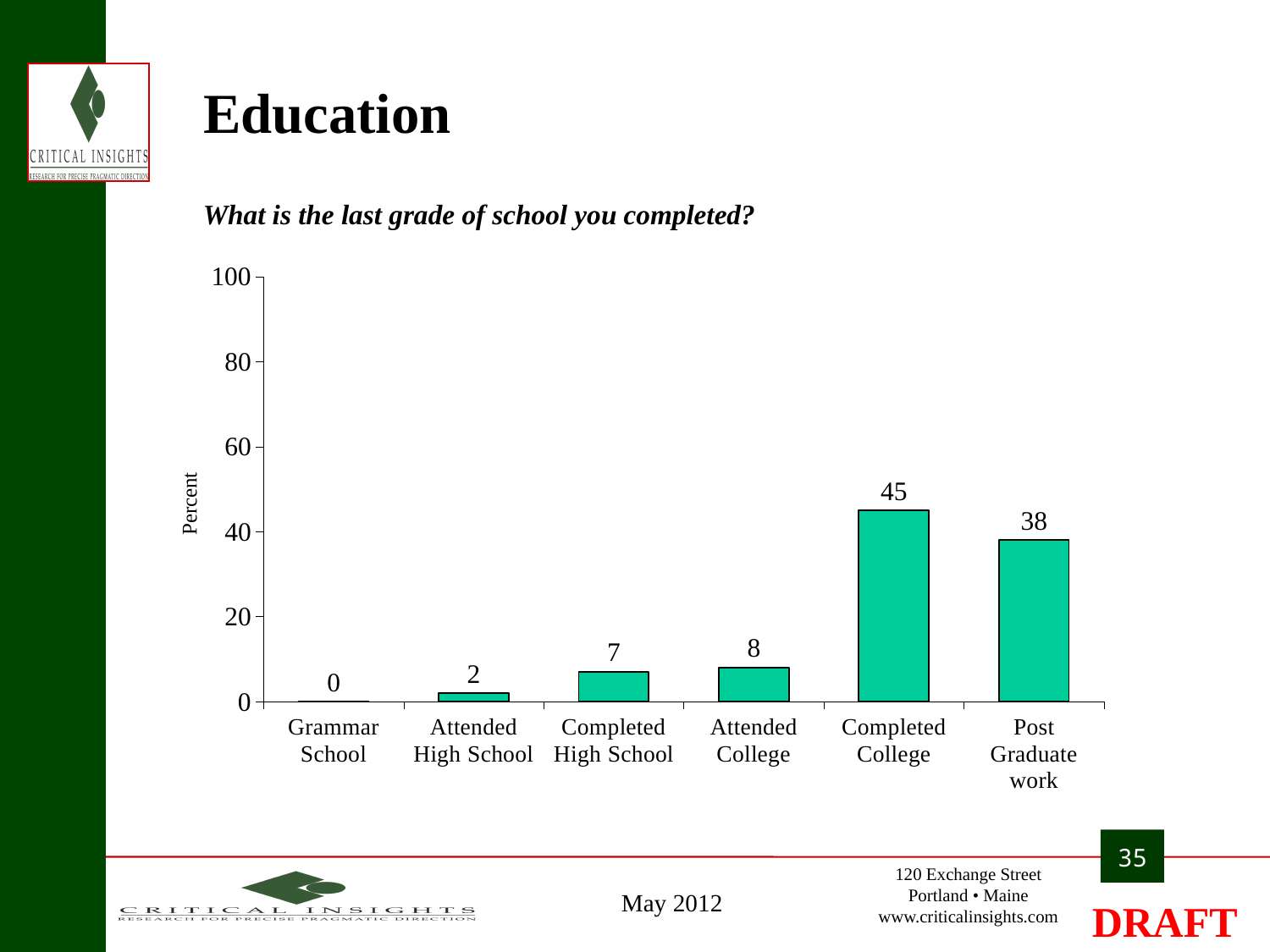
Which is larger, the value for Completed High School or the value for Attended College? Attended College Which category has the highest value? Completed College What kind of chart is shown on the slide? Bar chart What is the value for Attended High School? 2 Is the value for Completed College greater or less than 40? greater What is the value for Completed College? 45 What is the value for Post Graduate work? 38 What is the difference between the values for Completed College and Post Graduate work? 7 What is the label of the y axis? Percent How many categories are shown on the x axis? 6 What is the value for Attended College? 8 Which category has the lowest value? Grammar School